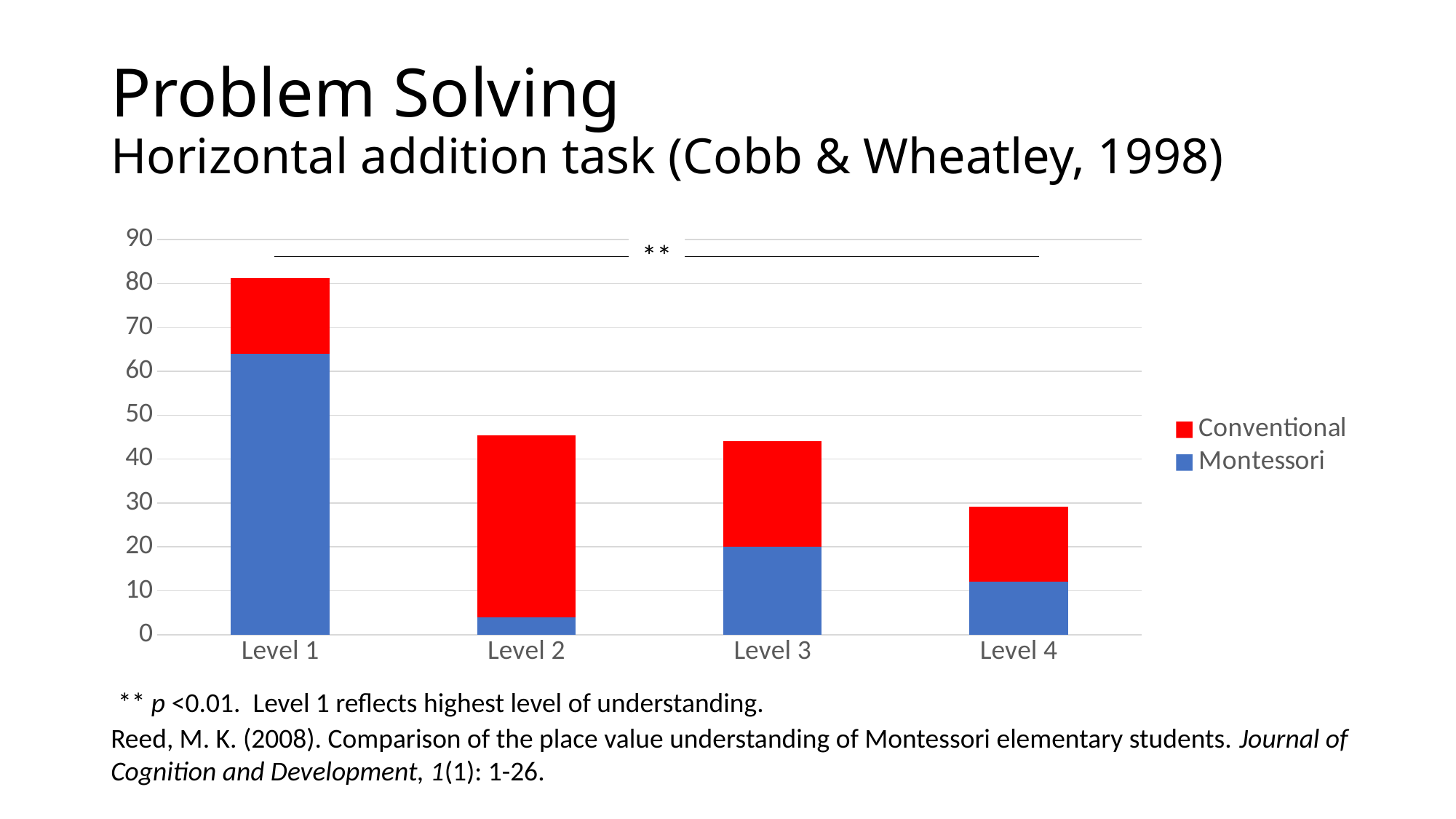
Is the total height of the Level 1 stacked bar greater or less than 70? greater Which level has the tallest stacked bar overall? Level 1 What kind of chart is shown on the slide? Stacked bar chart Is the Montessori value for Level 2 greater or less than 10? less Which level has the largest Montessori segment? Level 1 Which colour represents the Conventional series in the legend? Red How many levels are shown along the x axis of the chart? 4 Is the Montessori value for Level 1 greater or less than 60? greater Which level has the smallest Montessori segment? Level 2 Which is larger, the Montessori segment for Level 3 or for Level 4? Level 3 Which level has the shortest stacked bar overall? Level 4 How many series does the chart's legend list? 2